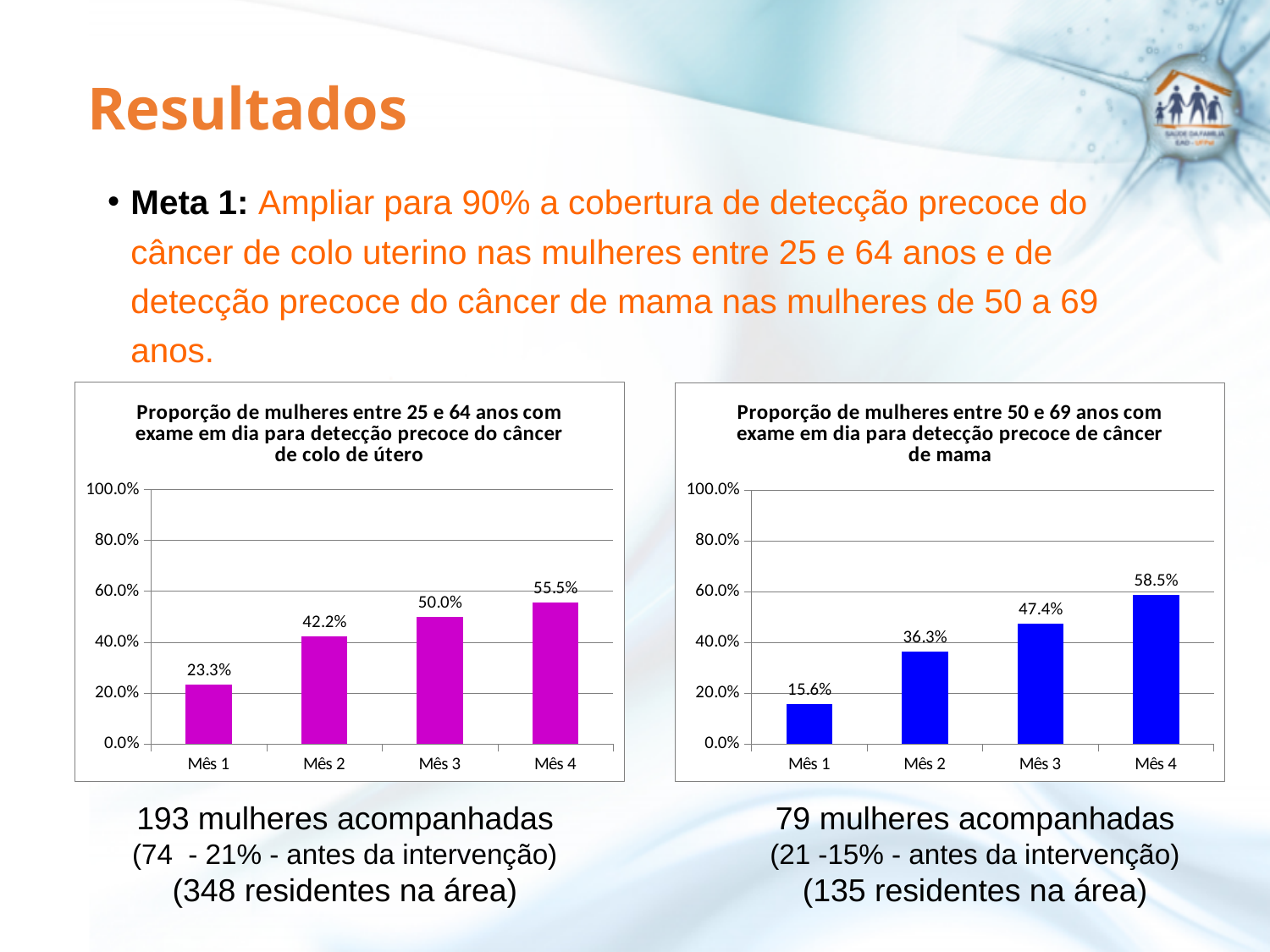
In the left chart (colo de útero), which month has the highest value? Mês 4 In the left chart (colo de útero), do the values rise or fall from Mês 1 to Mês 4? Rise In the left chart (colo de útero), what is the difference between Mês 4 and Mês 1? 32.2% How many months are shown on the x axis of the left chart (colo de útero)? 4 In the right chart (câncer de mama), is the value for Mês 2 greater or less than 40.0%? less In the right chart (câncer de mama), what is the value for Mês 3? 47.4% What colour are the bars in the right chart (câncer de mama)? Blue In the right chart (câncer de mama), what is the difference between Mês 2 and Mês 1? 20.7% Which is larger: Mês 4 in the left chart (colo de útero) or Mês 4 in the right chart (câncer de mama)? Mês 4 in the right chart (58.5%) In the right chart (câncer de mama), which month has the lowest value? Mês 1 In the left chart (colo de útero), what is the value for Mês 1? 23.3% What type of chart is the right chart (câncer de mama)? Bar chart